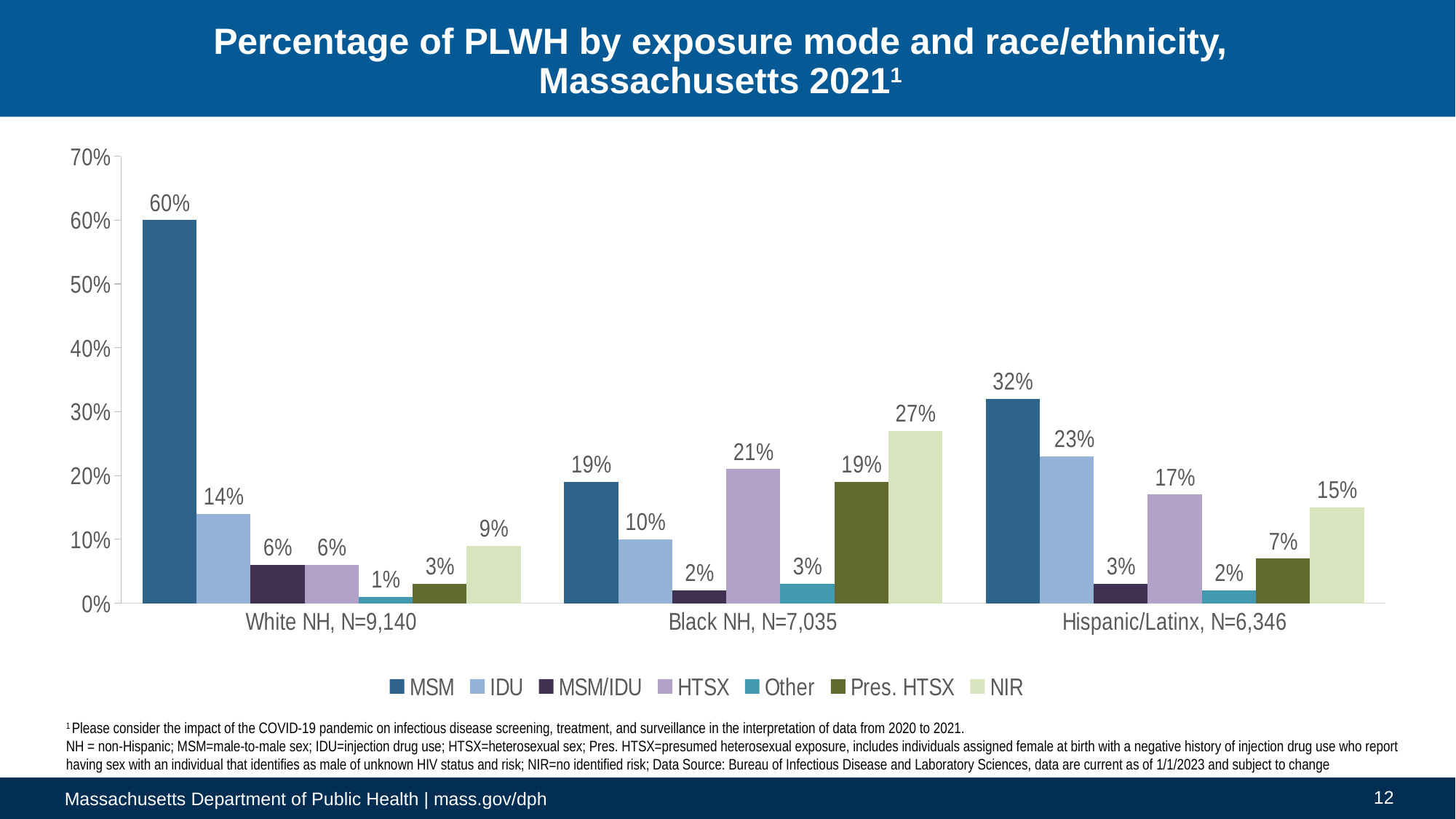
How many race/ethnicity groups are shown on the x axis? 3 What is the N for the Black NH group shown on the x axis? 7,035 What type of chart is shown on the slide? Bar chart What percentage of White NH PLWH have MSM as their exposure mode? 60% What is the difference between the MSM percentages for White NH and Hispanic/Latinx? 28% What is the IDU value for the Hispanic/Latinx group? 23% What is the difference between the NIR values for Black NH and Hispanic/Latinx? 12% Which exposure mode has the lowest percentage among White NH PLWH? Other What is the NIR value for the Black NH group? 27% Which is larger: the HTSX value for Black NH or the HTSX value for Hispanic/Latinx? Black NH How many exposure mode series does the legend list? 7 Which exposure mode has the highest percentage among Black NH PLWH? NIR